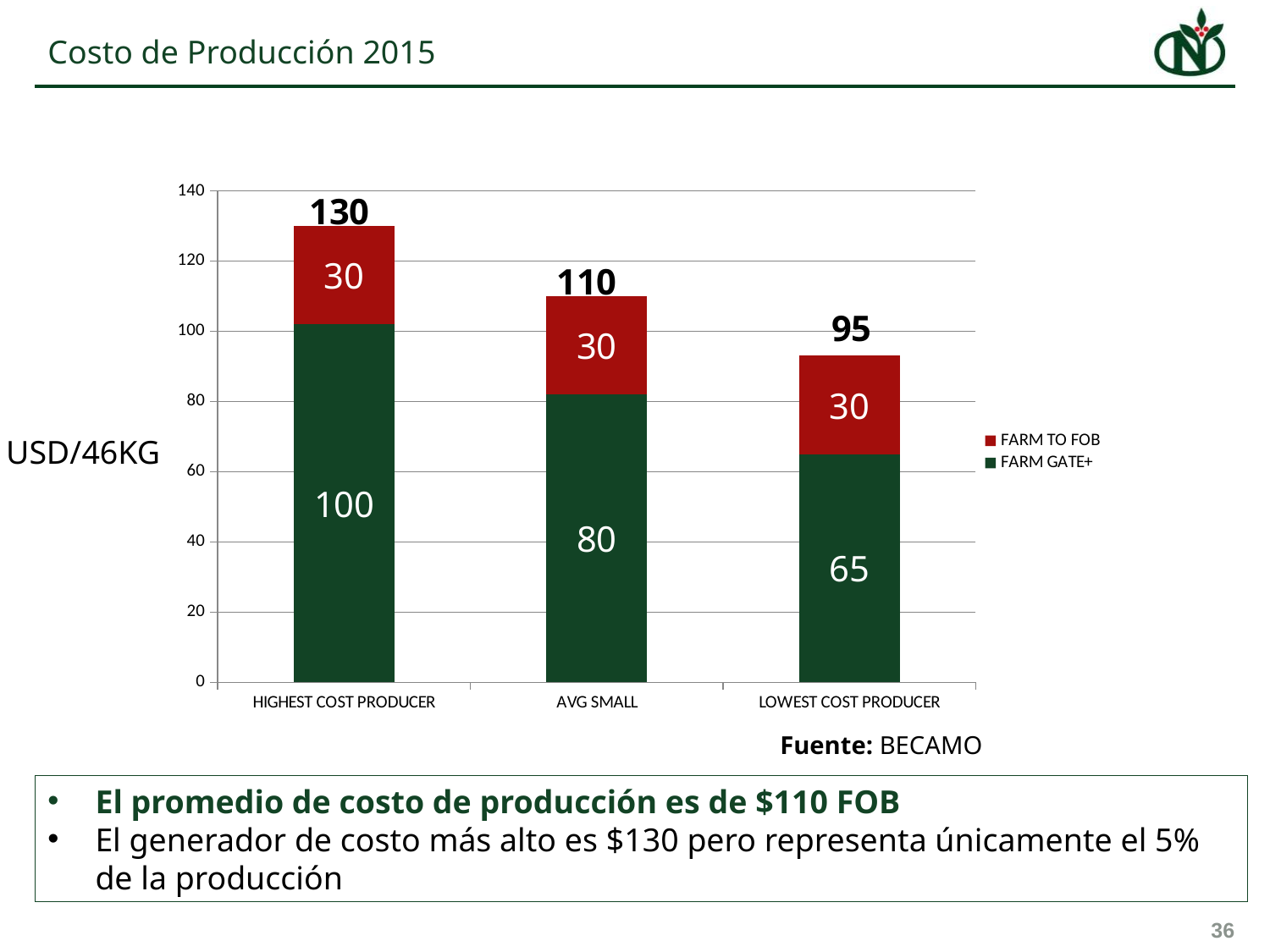
What is the total of the stacked bar for LOWEST COST PRODUCER? 95 How many series does the legend list? 2 Which category has the lowest FARM GATE+ value? LOWEST COST PRODUCER What kind of chart is shown on the slide? Stacked bar chart What is the total of the stacked bar for HIGHEST COST PRODUCER? 130 What is the FARM GATE+ value for LOWEST COST PRODUCER? 65 What is the difference between the total for HIGHEST COST PRODUCER and the total for AVG SMALL? 20 What is the FARM TO FOB value for AVG SMALL? 30 Which is larger, the FARM GATE+ value for AVG SMALL or for LOWEST COST PRODUCER? AVG SMALL What is the FARM GATE+ value for AVG SMALL? 80 What is the FARM GATE+ value for HIGHEST COST PRODUCER? 100 Which category has the highest total cost? HIGHEST COST PRODUCER